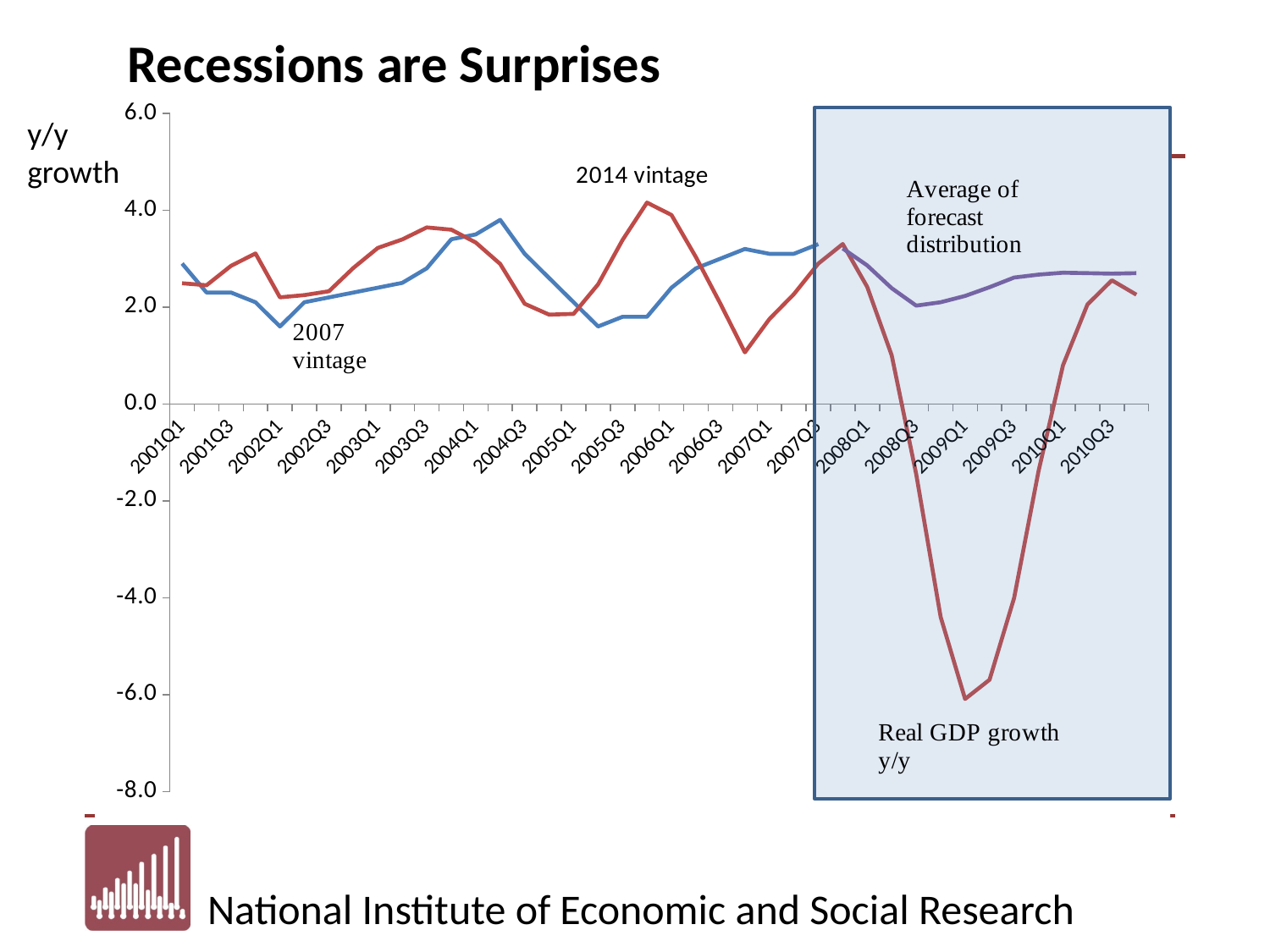
What kind of chart is shown on the slide? line chart At which quarter does the Real GDP growth y/y line reach its lowest point? 2009Q1 At which quarter does the 2014 vintage line reach its highest point? 2005Q4 Is the value of the Average of forecast distribution line at 2010Q1 greater or less than 2.0? greater Does the Real GDP growth y/y line rise or fall between 2008Q1 and 2009Q1? fall Is the value of the Real GDP growth y/y line at 2009Q1 greater or less than -4.0? less How many data series (lines) are plotted on the chart? 3 Is the value of the 2007 vintage line at 2002Q1 greater or less than 2.0? less What is the title of the slide's chart? Recessions are Surprises At 2006Q1, which line is higher: the 2007 vintage or the 2014 vintage? 2014 vintage Which series is drawn in purple inside the shaded box? Average of forecast distribution